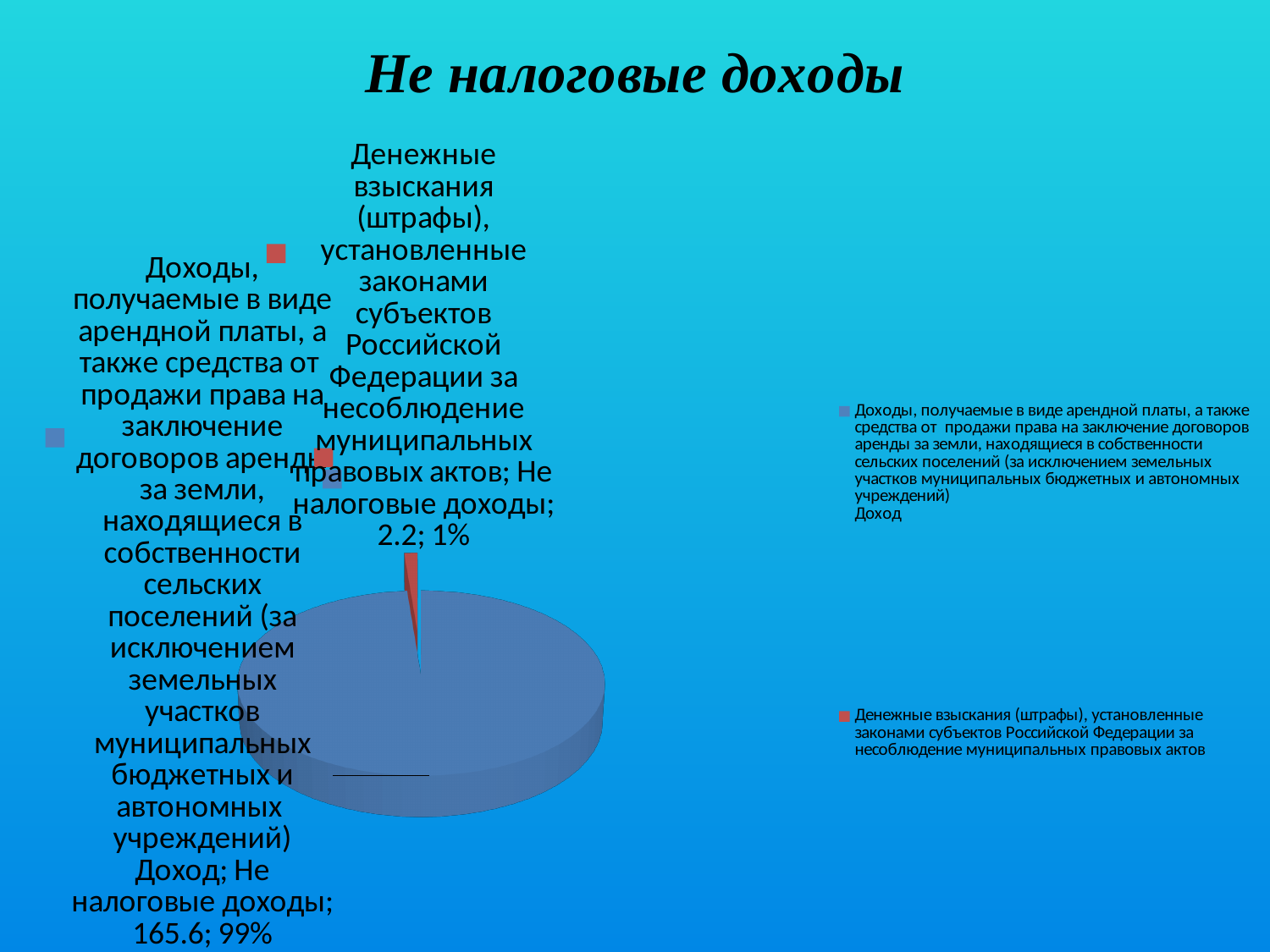
What kind of chart is shown on the slide? pie chart What is the value for Доходы, получаемые в виде арендной платы? 165.6 How many entries does the legend list? 2 What is the title of the chart? Не налоговые доходы Which colour is used for the Денежные взыскания (штрафы) slice? red What is the difference between the value for Доходы, получаемые в виде арендной платы and the value for Денежные взыскания (штрафы)? 163.4 What share of the pie does Денежные взыскания (штрафы) represent? 1% Which category has the smallest slice? Денежные взыскания (штрафы) Which category has the largest slice? Доходы, получаемые в виде арендной платы How many slices does the pie chart have? 2 What share of the pie does Доходы, получаемые в виде арендной платы represent? 99% What is the value for Денежные взыскания (штрафы)? 2.2